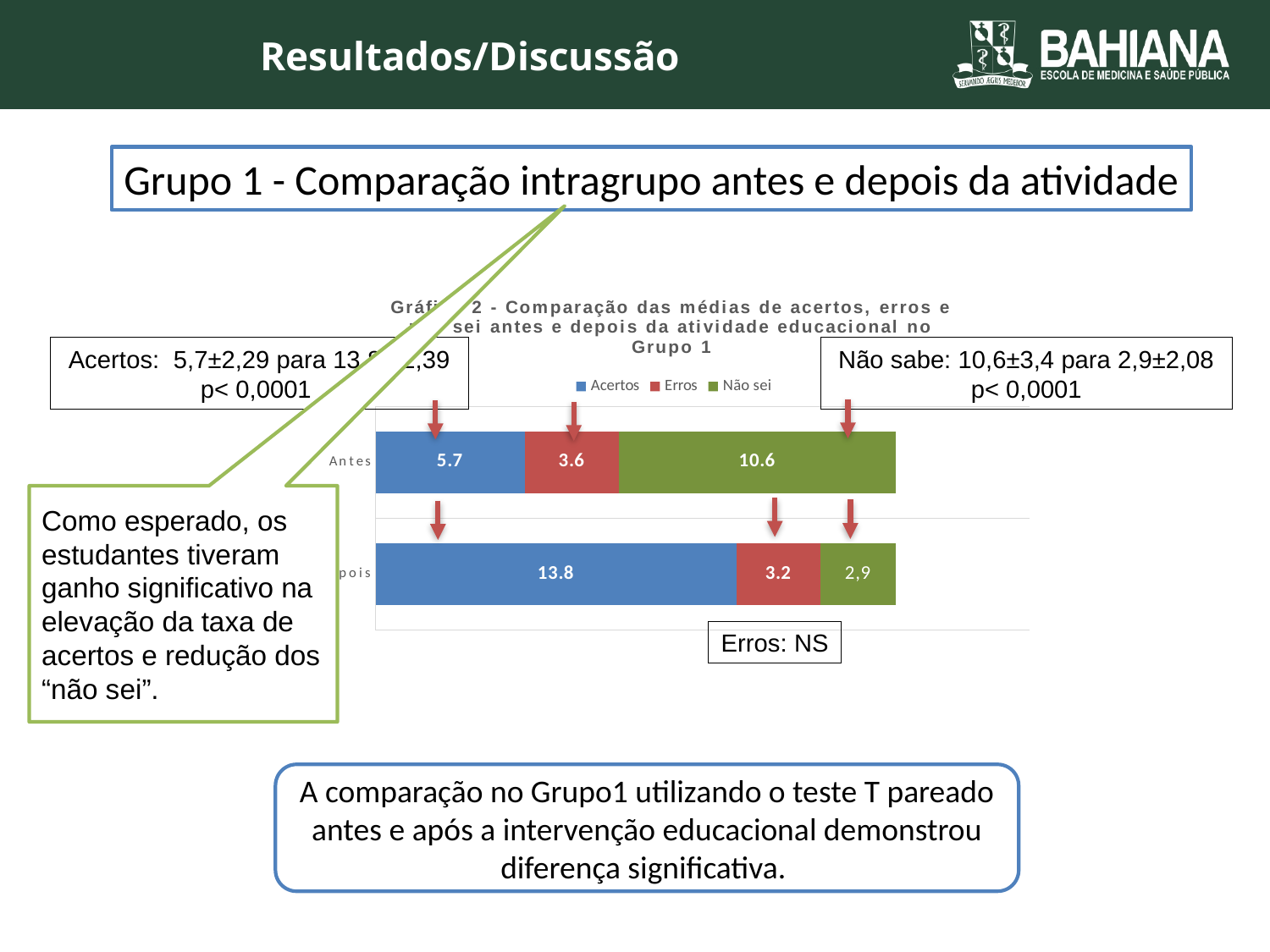
Which series has the largest value in the Antes bar? Não sei What is the Acertos value for Antes? 5.7 Which series has the smallest value in the Depois bar? Não sei By how much did the Acertos value increase from Antes to Depois? 8.1 What is the Erros value for Depois? 3.2 What is the total of the Antes stacked bar? 19.9 Is the Erros value larger for Antes or for Depois? Antes What is the Acertos value for Depois? 13.8 What is the Não sei value for Depois? 2,9 What is the Não sei value for Antes? 10.6 What type of chart is shown on the slide? Stacked bar chart How many series does the chart legend list? 3